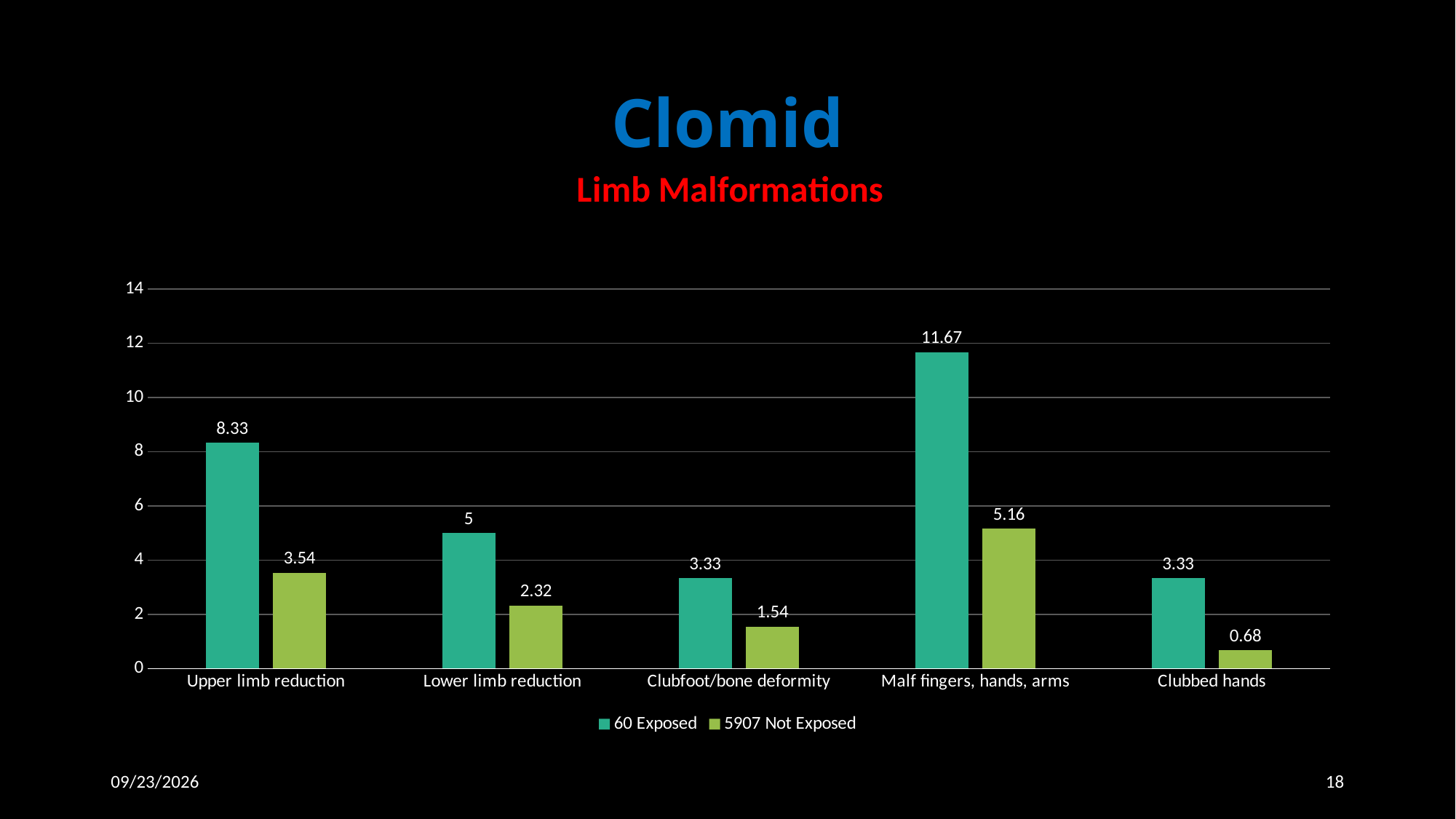
What are the two series names in the legend? 60 Exposed and 5907 Not Exposed Which category has the lowest value for 5907 Not Exposed? Clubbed hands How many categories are shown on the x axis? 5 How many series does the legend list? 2 What is the value for 5907 Not Exposed for Clubbed hands? 0.68 What is the difference between the 60 Exposed and 5907 Not Exposed values for Upper limb reduction? 4.79 Which category has the highest value for 60 Exposed? Malf fingers, hands, arms What is the value for 60 Exposed for Malf fingers, hands, arms? 11.67 What kind of chart is shown on the slide? Bar chart What is the value for 5907 Not Exposed for Lower limb reduction? 2.32 Which is larger: the 5907 Not Exposed value for Malf fingers, hands, arms or the 60 Exposed value for Lower limb reduction? 5907 Not Exposed for Malf fingers, hands, arms Is the 60 Exposed value for Upper limb reduction greater or less than 8? greater